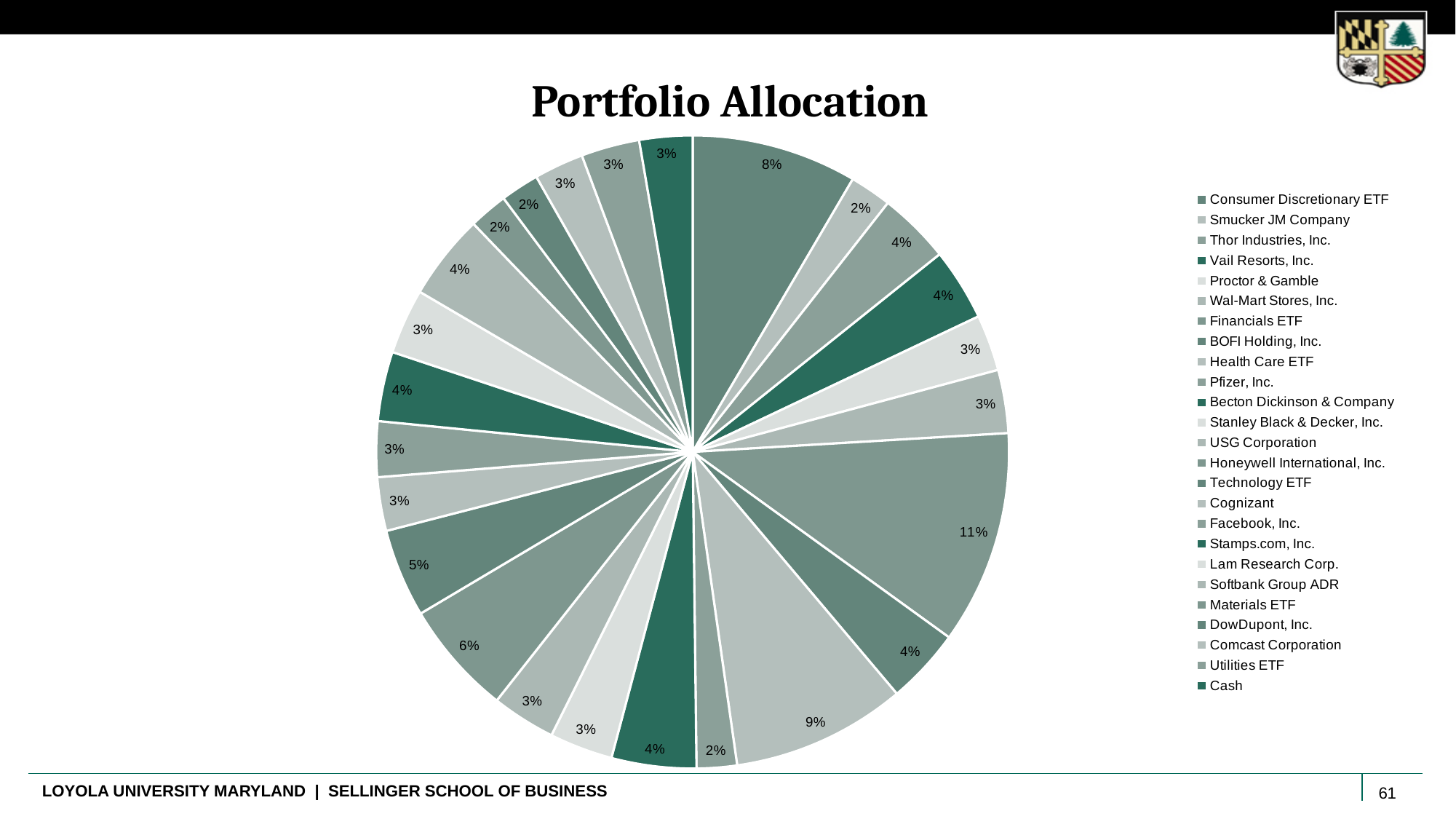
What share of the portfolio is held as Cash? 3% How many slices does the pie chart have? 25 What share of the portfolio is Consumer Discretionary ETF? 8% What share of the portfolio is Health Care ETF? 9% What is the largest share shown in the pie chart? 11% Which is larger, the share for Financials ETF or the share for Health Care ETF? Financials ETF What is the difference between the Financials ETF share (11%) and the Consumer Discretionary ETF share (8%)? 3% Which holding has the largest share of the portfolio? Financials ETF What kind of chart is shown on the slide? pie chart How many holdings does the legend list? 25 What is the title of the chart? Portfolio Allocation What is the smallest share shown in the pie chart? 2%